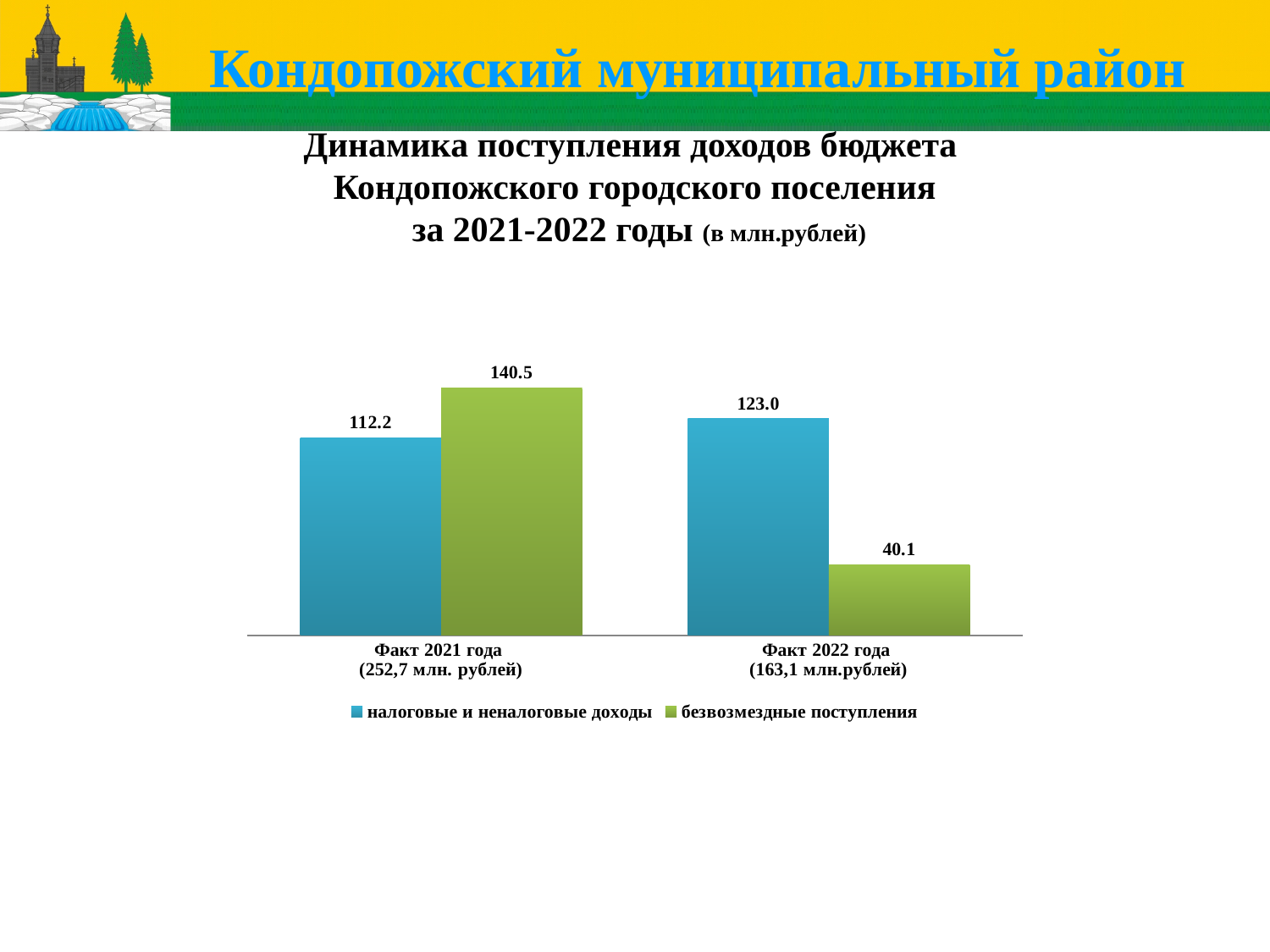
How many series does the legend list? 2 What is the value of налоговые и неналоговые доходы for Факт 2022 года? 123.0 Which is larger for Факт 2022 года: налоговые и неналоговые доходы or безвозмездные поступления? налоговые и неналоговые доходы What is the difference between безвозмездные поступления in Факт 2021 года and Факт 2022 года? 100.4 What is the value of безвозмездные поступления for Факт 2021 года? 140.5 What kind of chart is shown on the slide? bar chart Which bar has the highest value on the chart? безвозмездные поступления, Факт 2021 года Does the value of налоговые и неналоговые доходы rise or fall from Факт 2021 года to Факт 2022 года? rise How many categories are shown on the x axis? 2 What is the value of безвозмездные поступления for Факт 2022 года? 40.1 Which bar has the lowest value on the chart? безвозмездные поступления, Факт 2022 года What is the value of налоговые и неналоговые доходы for Факт 2021 года? 112.2